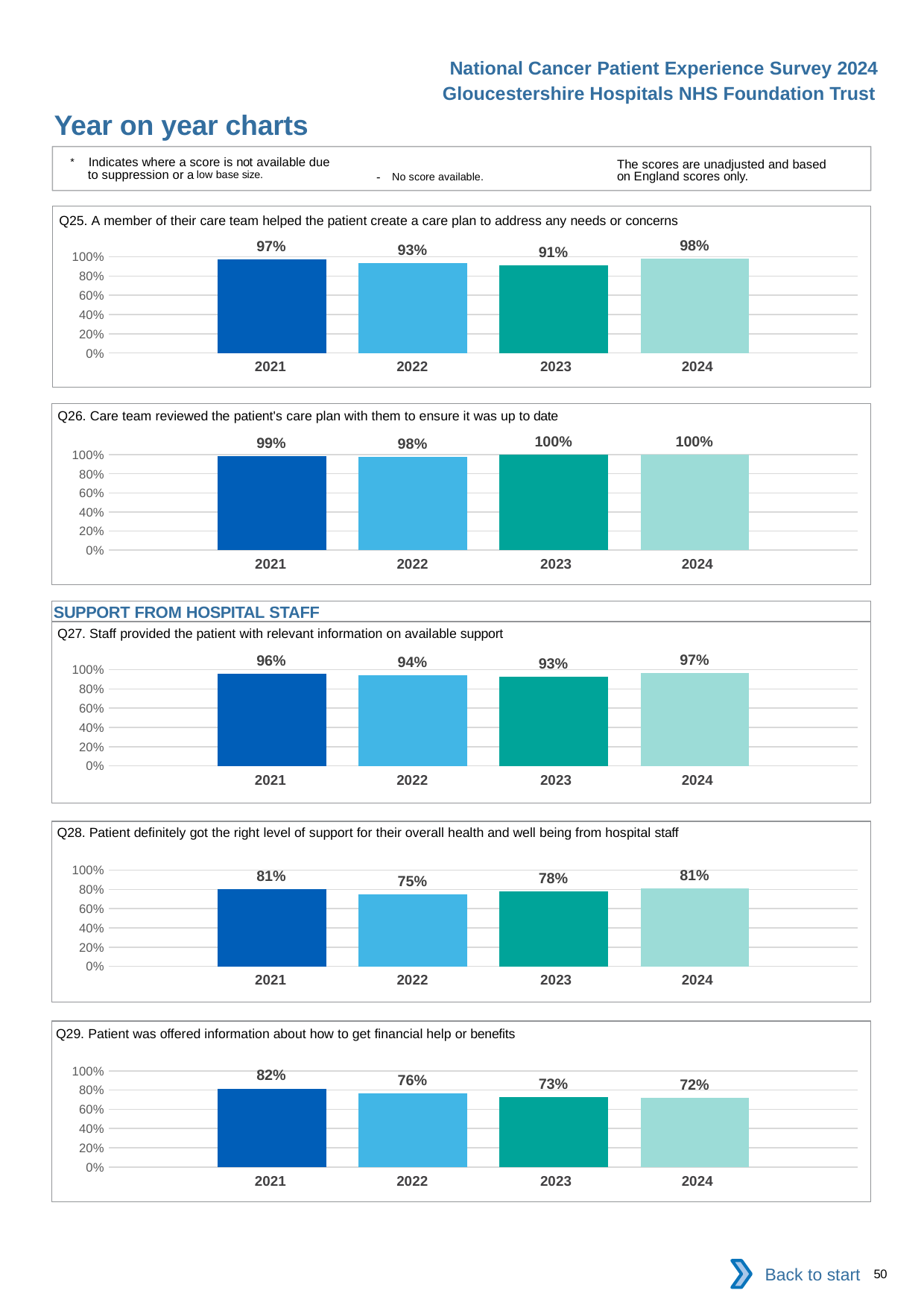
In the Q27 chart (staff provided information on available support), what is the value for 2023? 93% How many years are shown on the x axis of the Q29 chart (information about financial help or benefits)? 4 In the Q26 chart (care team reviewed the care plan), what is the value for 2022? 98% In the Q28 chart (right level of support from hospital staff), what is the value for 2022? 75% In the Q26 chart (care team reviewed the care plan), what is the difference between the 2021 and 2022 values? 1% What kind of chart is the Q28 chart (right level of support from hospital staff)? bar chart In the Q25 chart (care team helped create a care plan), what is the value for 2024? 98% In the Q29 chart (information about financial help or benefits), do the values rise or fall from 2021 to 2024? fall In the Q27 chart (staff provided information on available support), which year has the highest value? 2024 In the Q28 chart (right level of support from hospital staff), what is the difference between the 2021 and 2022 values? 6% In the Q29 chart (information about financial help or benefits), which is larger, the value for 2021 or the value for 2024? 2021 In the Q25 chart (care team helped create a care plan), which year has the lowest value? 2023